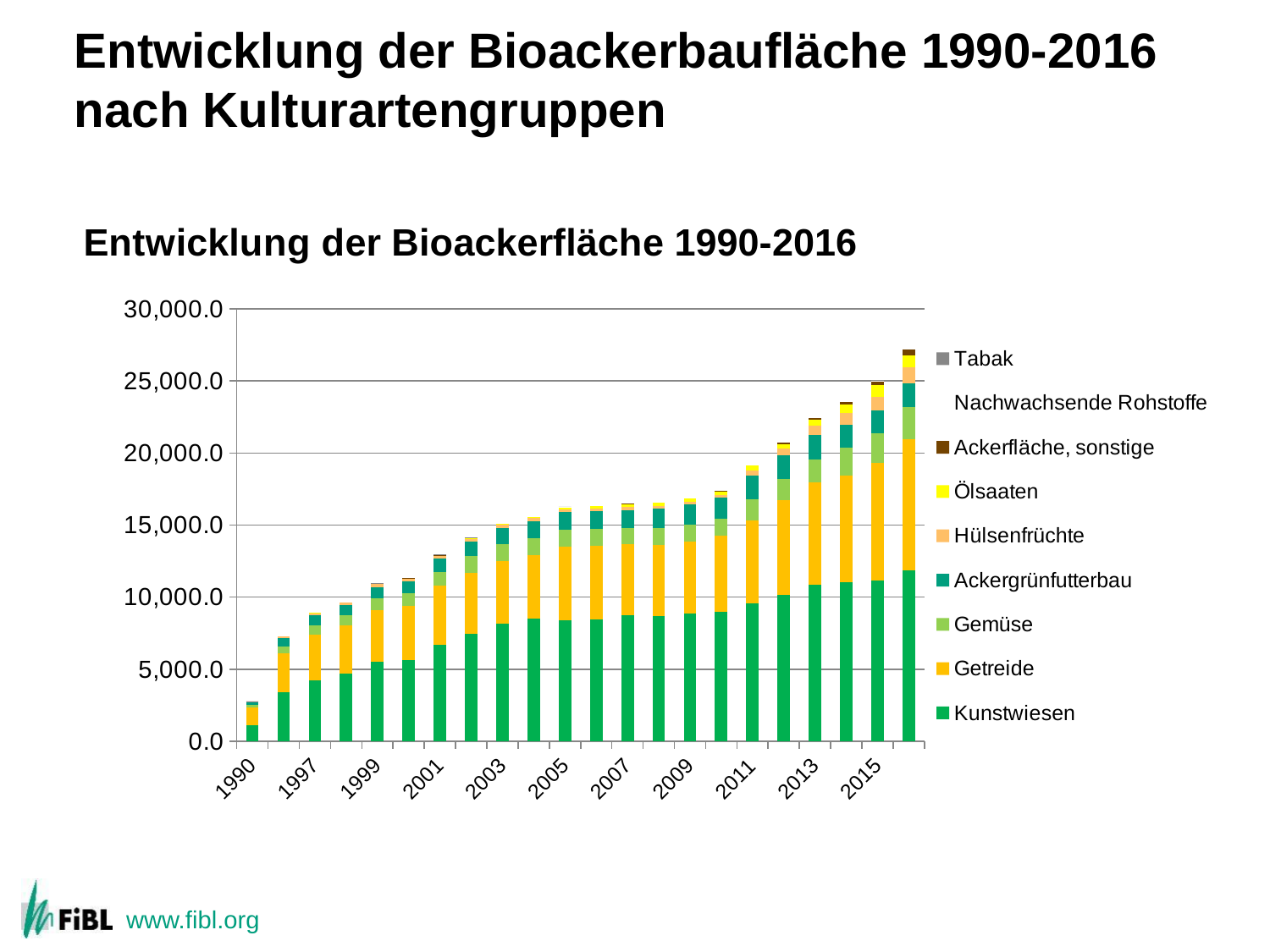
Which year has the larger total bar, 2001 or 2013? 2013 What kind of chart is shown on the slide? Stacked bar chart Which series is shown at the bottom of each stacked bar? Kunstwiesen What is the title of the chart? Entwicklung der Bioackerfläche 1990-2016 How many series does the legend list? 9 Do the total bar heights generally rise or fall from 1990 to the right end of the x axis? Rise Is the total value for 2001 greater or less than 10,000.0? greater Is the total value for 1997 greater or less than 10,000.0? less Is the total value for 2007 greater or less than 15,000.0? greater Which labelled year has the lowest total bar? 1990